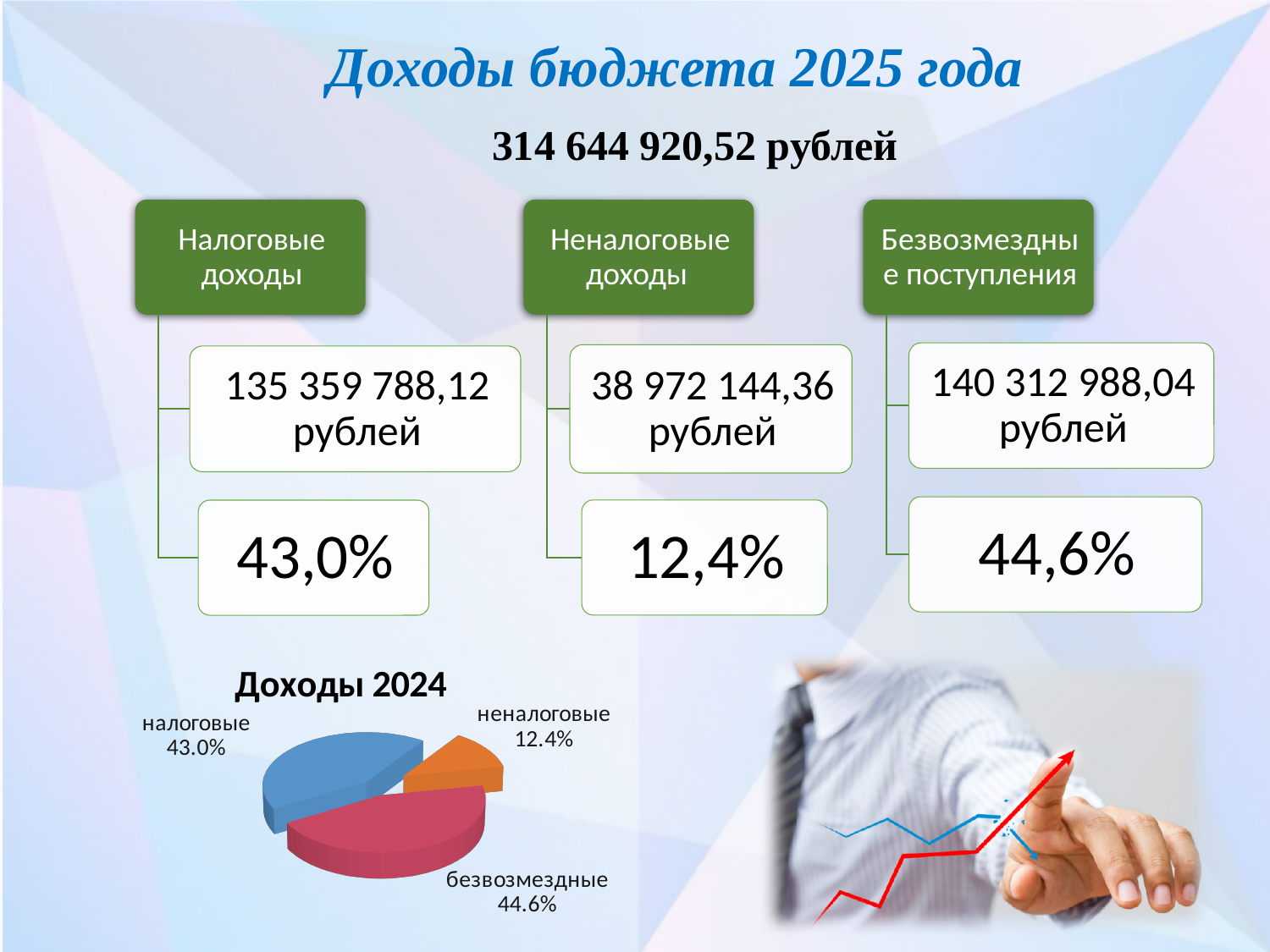
What share of the pie does the неналоговые slice represent? 12.4% How many slices does the pie chart have? 3 What is the difference in percentage points between the безвозмездные and налоговые slices? 1.6 What colour is the безвозмездные slice in the pie chart? red What is the title of the pie chart? Доходы 2024 Which slice of the pie chart is the smallest? неналоговые What type of chart is shown on the slide? pie chart What share of the pie does the безвозмездные slice represent? 44.6% Which is larger in the pie chart, налоговые or неналоговые? налоговые What is the difference in percentage points between the налоговые and неналоговые slices? 30.6 Which slice of the pie chart is the largest? безвозмездные What share of the pie does the налоговые slice represent? 43.0%